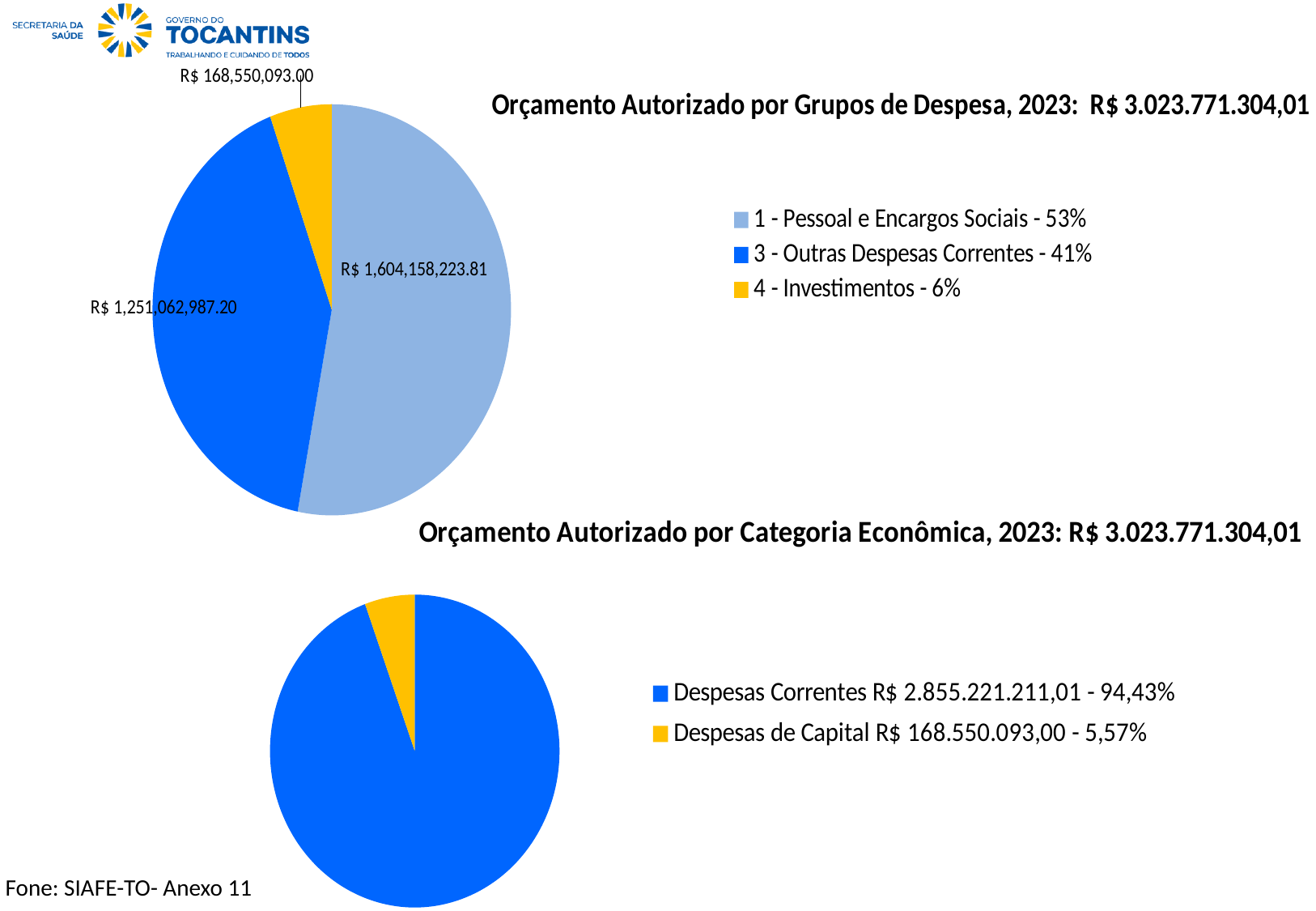
How many slices does the top chart 'Orçamento Autorizado por Grupos de Despesa, 2023' have? 3 In the bottom chart 'Orçamento Autorizado por Categoria Econômica, 2023', what is the value given for 'Despesas de Capital'? R$ 168.550.093,00 In the bottom chart 'Orçamento Autorizado por Categoria Econômica, 2023', what share of the pie is 'Despesas Correntes'? 94,43% In the top chart 'Orçamento Autorizado por Grupos de Despesa, 2023', what is the value labelled for the '3 - Outras Despesas Correntes' slice? R$ 1,251,062,987.20 What kind of chart is the top chart, 'Orçamento Autorizado por Grupos de Despesa, 2023'? Pie chart In the top chart 'Orçamento Autorizado por Grupos de Despesa, 2023', what share of the pie does '1 - Pessoal e Encargos Sociais' represent? 53% In the bottom chart 'Orçamento Autorizado por Categoria Econômica, 2023', what colour is the 'Despesas de Capital' slice? Yellow How many entries does the legend of the bottom chart 'Orçamento Autorizado por Categoria Econômica, 2023' list? 2 In the top chart 'Orçamento Autorizado por Grupos de Despesa, 2023', which group has the largest slice? 1 - Pessoal e Encargos Sociais In the top chart 'Orçamento Autorizado por Grupos de Despesa, 2023', what is the value labelled for the '1 - Pessoal e Encargos Sociais' slice? R$ 1,604,158,223.81 In the top chart 'Orçamento Autorizado por Grupos de Despesa, 2023', what is the value labelled for the '4 - Investimentos' slice? R$ 168,550,093.00 In the top chart 'Orçamento Autorizado por Grupos de Despesa, 2023', which group has the smallest slice? 4 - Investimentos